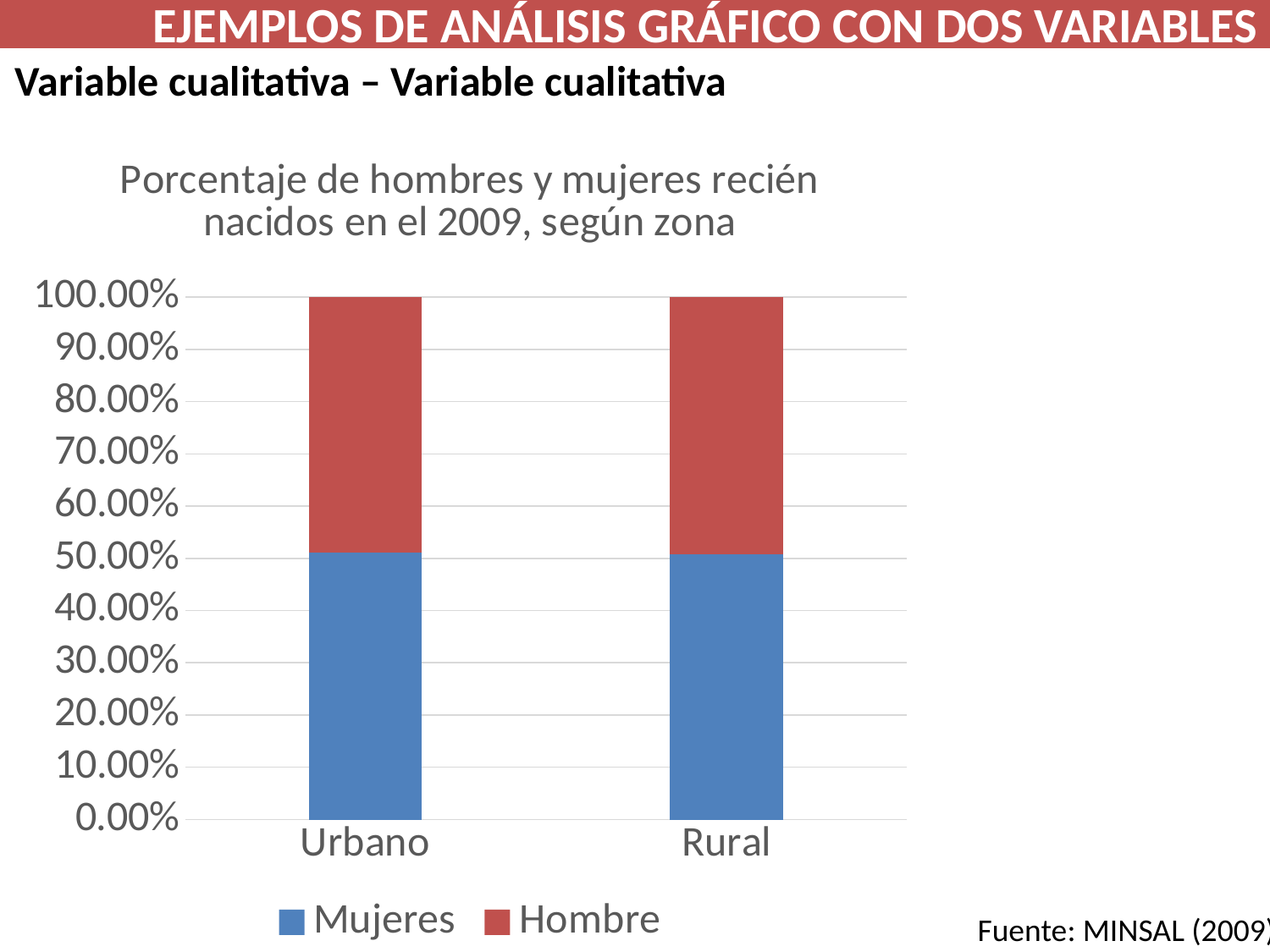
Is the value for Mujeres in Urbano greater or less than 40.00%? greater Is the value for Mujeres in Urbano greater or less than 60.00%? less How many series does the chart legend list? 2 What kind of chart is shown on the slide? stacked bar chart What are the two categories shown on the x axis of the chart? Urbano and Rural What is the total height of the stacked bar for Urbano? 100.00% Is the value for Mujeres in Rural greater or less than 60.00%? less What is the total height of the stacked bar for Rural? 100.00% What is the title of the chart? Porcentaje de hombres y mujeres recién nacidos en el 2009, según zona Which series is shown in blue in the chart? Mujeres How many categories are shown on the x axis of the chart? 2